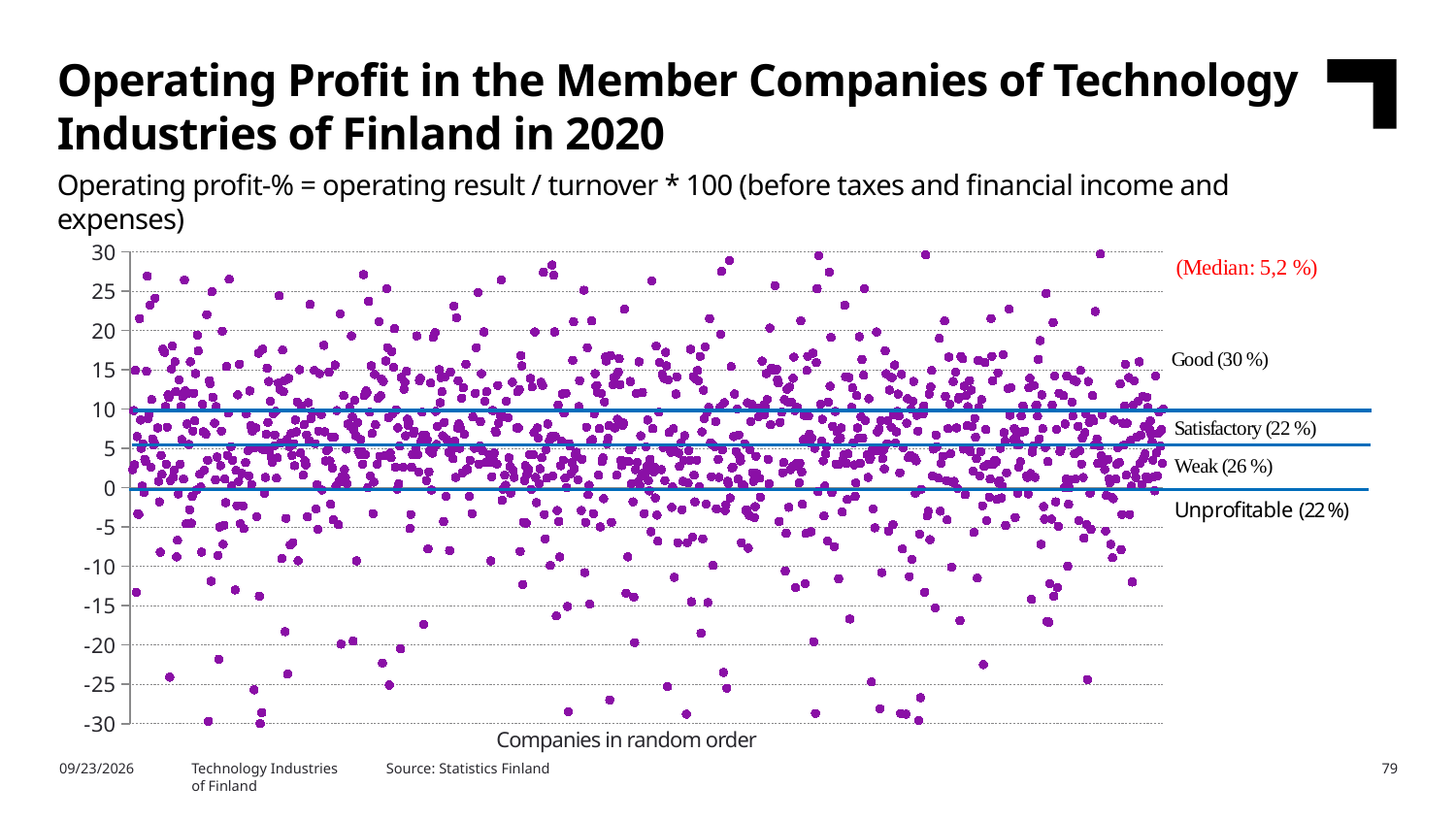
What is the difference in percentage points between the 'Good' share and the 'Weak' share? 4 percentage points How many profitability categories are labelled on the chart? 4 What is the median operating profit-% shown on the chart? 5,2 % What is the highest value shown on the y axis? 30 What is the label of the x axis? Companies in random order Which has a larger share of companies, 'Good' or 'Weak'? Good What share of companies falls into the 'Good' category? 30 % What share of companies falls into the 'Unprofitable' category? 22 % What kind of chart is shown on the slide? Scatter chart Which profitability category has the largest share of companies? Good Is the median operating profit-% greater or less than 5? greater What share of companies falls into the 'Weak' category? 26 %